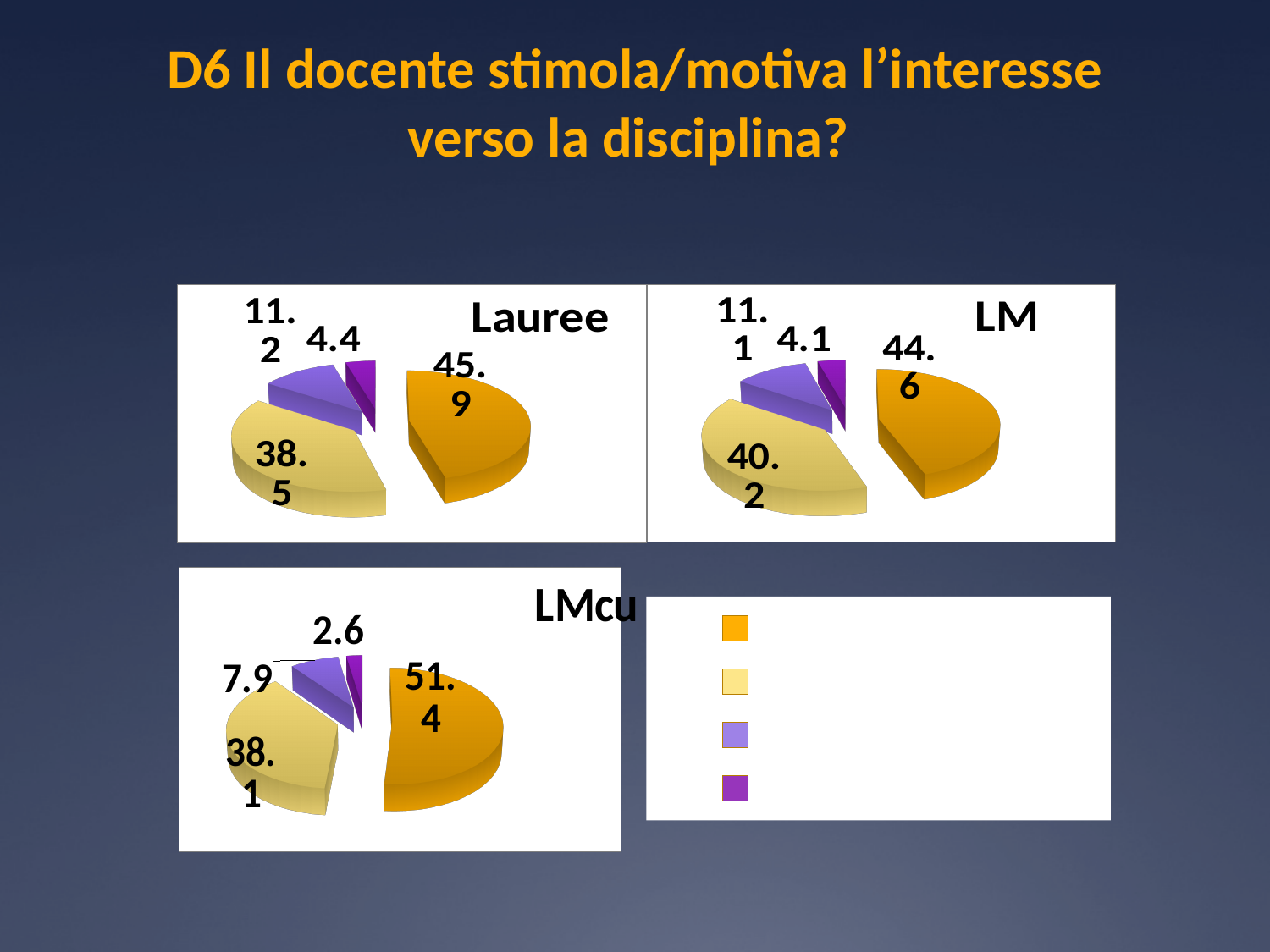
What is the title of the chart in the bottom-left position? LMcu How many colour entries does the legend box show? 4 What type of chart is used for Lauree, LM and LMcu? pie chart Which is larger: the light purple slice in the Lauree chart or the light purple slice in the LMcu chart? Lauree (11.2) In the LM pie chart, which slice has the largest value? the orange slice (44.6) How many slices does the LM pie chart have? 4 In the LM pie chart, what is the value of the light yellow slice? 40.2 In the LMcu pie chart, what is the difference between the orange slice and the light yellow slice? 13.3 In the Lauree pie chart, which slice has the smallest value? the dark purple slice (4.4) In the Lauree pie chart, what is the value of the orange slice? 45.9 In the LMcu pie chart, what is the value of the dark purple slice? 2.6 In the LMcu pie chart, what is the value of the light purple slice? 7.9